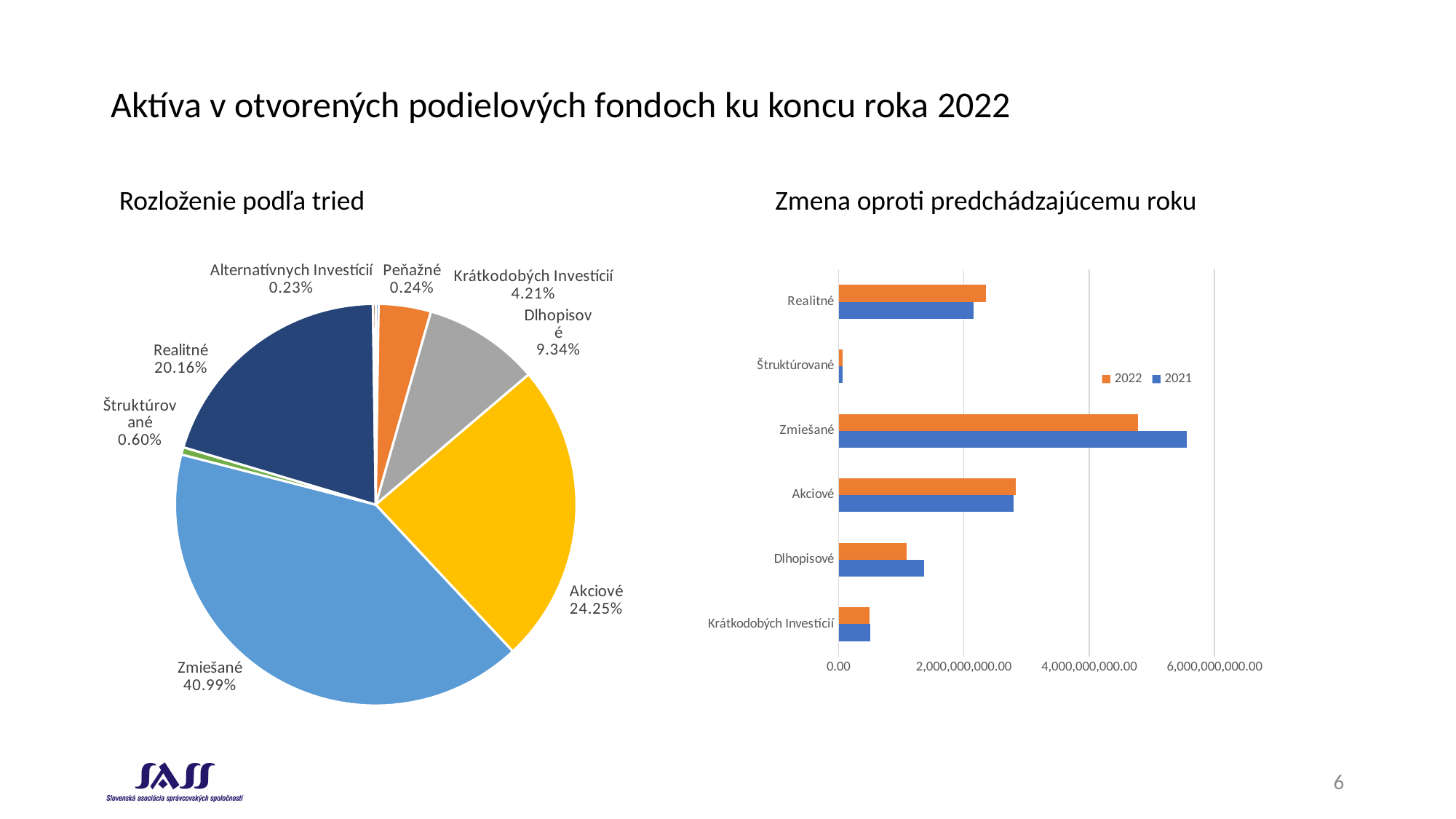
In the bar chart "Zmena oproti predchádzajúcemu roku", which is larger for Zmiešané, the 2022 value or the 2021 value? 2021 In the bar chart "Zmena oproti predchádzajúcemu roku", is the 2021 value for Zmiešané greater or less than 4,000,000,000.00? greater In the pie chart "Rozloženie podľa tried", which category has the largest share? Zmiešané In the pie chart "Rozloženie podľa tried", which category has the smallest share? Alternatívnych Investícií In the pie chart "Rozloženie podľa tried", what is the difference in percentage points between Akciové and Realitné? 4.09 In the bar chart "Zmena oproti predchádzajúcemu roku", how many series does the legend list? 2 In the bar chart "Zmena oproti predchádzajúcemu roku", is the 2022 value for Dlhopisové greater or less than 2,000,000,000.00? less In the pie chart "Rozloženie podľa tried", how many slices are there? 8 In the pie chart "Rozloženie podľa tried", what share does Zmiešané have? 40.99% In the pie chart "Rozloženie podľa tried", what is the percentage for Akciové? 24.25% In the bar chart "Zmena oproti predchádzajúcemu roku", how many categories are shown? 6 In the pie chart "Rozloženie podľa tried", what is the percentage for Realitné? 20.16%